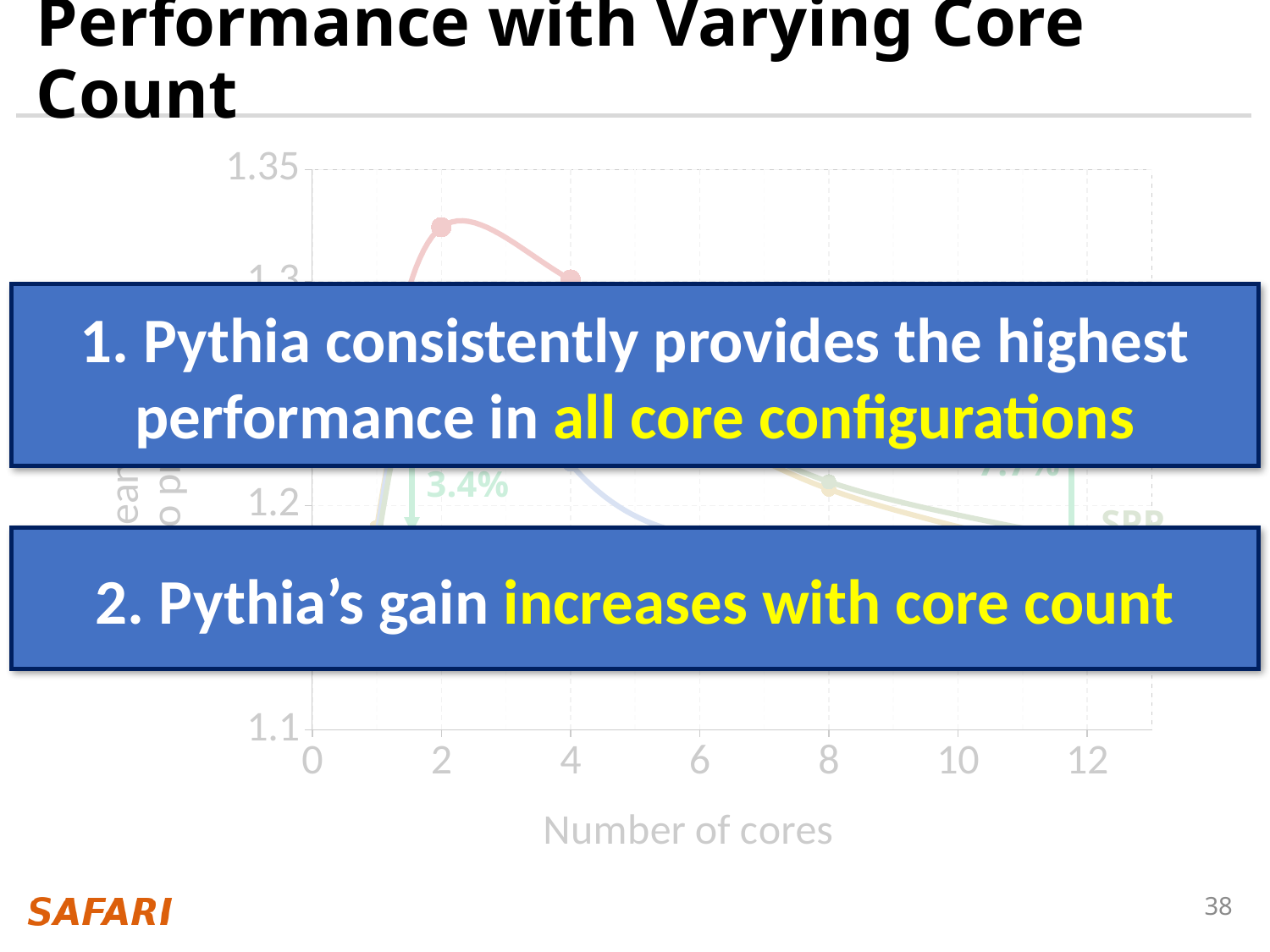
What kind of chart is shown on the slide? line chart What is the lowest tick value shown on the y axis of the chart? 1.1 Does the red line rise or fall between 2 cores and 4 cores? fall What is the highest tick value shown on the y axis of the chart? 1.35 How many tick marks are labelled on the x axis of the chart? 7 Is the value of the red line at 2 cores greater or less than 1.3? greater What is the largest number of cores marked on the x axis of the chart? 12 What is the label of the x axis of the chart? Number of cores